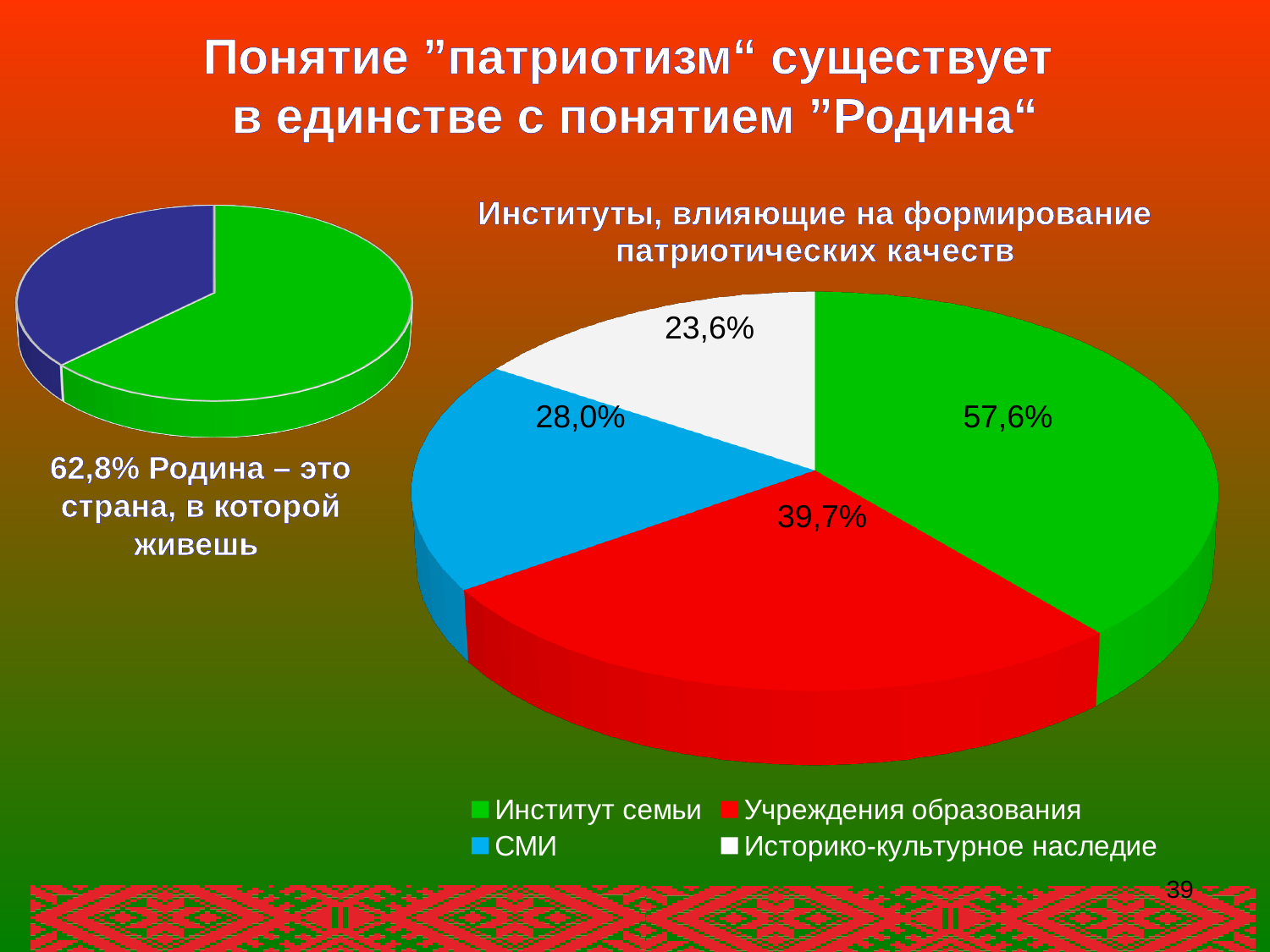
In the chart titled "Институты, влияющие на формирование патриотических качеств", how many categories does the legend list? 4 In the chart titled "Институты, влияющие на формирование патриотических качеств", which category has the lowest value? Историко-культурное наследие In the chart titled "Институты, влияющие на формирование патриотических качеств", what is the value for Историко-культурное наследие? 23,6% In the chart titled "Институты, влияющие на формирование патриотических качеств", what is the difference between the values for Институт семьи and Учреждения образования? 17,9% In the chart titled "Институты, влияющие на формирование патриотических качеств", what is the value for Институт семьи? 57,6% In the chart titled "Институты, влияющие на формирование патриотических качеств", what is the value for СМИ? 28,0% In the chart titled "Институты, влияющие на формирование патриотических качеств", which category has the highest value? Институт семьи In the chart titled "Институты, влияющие на формирование патриотических качеств", which colour represents Учреждения образования? Red In the chart titled "Институты, влияющие на формирование патриотических качеств", which is larger: СМИ or Историко-культурное наследие? СМИ What kind of chart is the chart titled "Институты, влияющие на формирование патриотических качеств"? Pie chart In the chart titled "Институты, влияющие на формирование патриотических качеств", what is the value for Учреждения образования? 39,7% In the pie chart on the left of the slide, which slice is larger: the green slice or the blue slice? The green slice